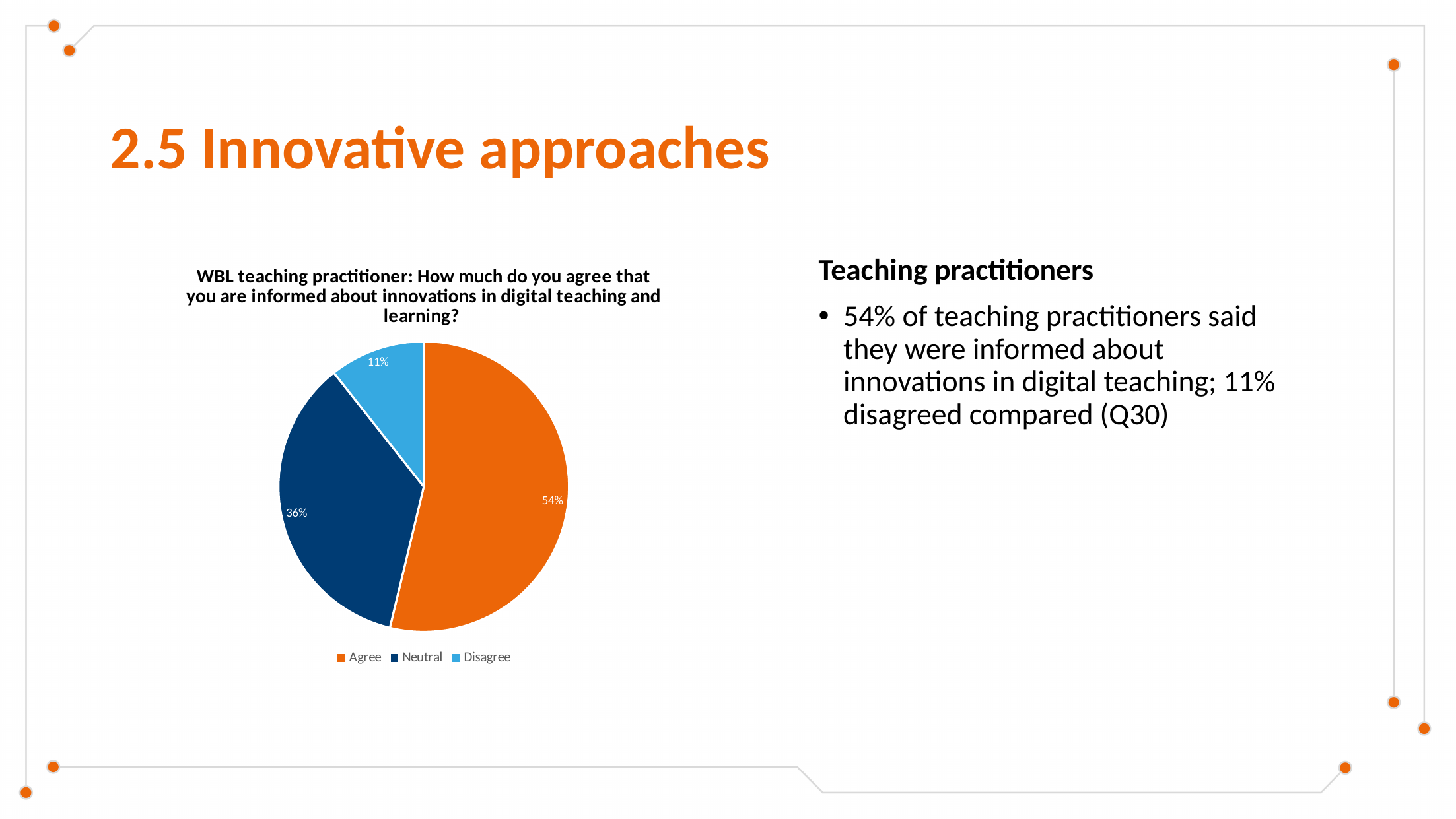
What percentage of respondents chose Agree? 54% Which response has the largest share of the pie? Agree What percentage of respondents chose Disagree? 11% Which response has the smallest share of the pie? Disagree What percentage of respondents chose Neutral? 36% Which is larger, the share for Neutral or the share for Disagree? Neutral How many slices does the pie chart have? 3 What is the difference in percentage points between Neutral and Disagree? 25 How many entries does the legend list? 3 What colour is the Agree slice? orange What type of chart is shown on the slide? pie chart What is the difference in percentage points between Agree and Neutral? 18